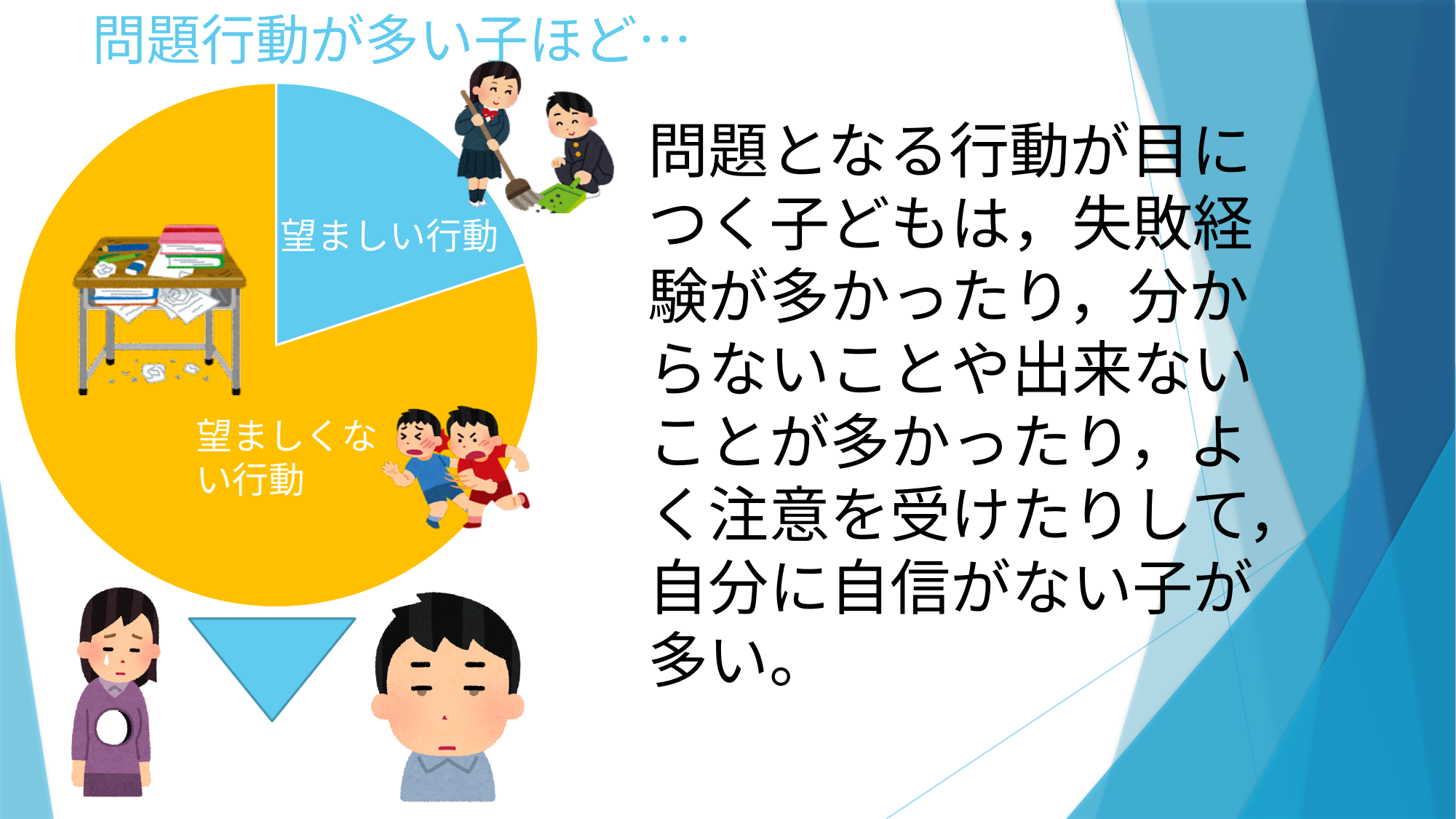
What colour is the 望ましくない行動 slice in the pie chart? orange Does the 望ましくない行動 slice take up more or less than half of the pie chart? more How many slices does the pie chart have? 2 What kind of chart is shown on the left of the slide? pie chart What colour is the 望ましい行動 slice in the pie chart? blue Does the 望ましい行動 slice take up more or less than half of the pie chart? less Which slice of the pie chart is the largest? 望ましくない行動 In the pie chart, which is larger: 望ましい行動 or 望ましくない行動? 望ましくない行動 Which slice of the pie chart is the smallest? 望ましい行動